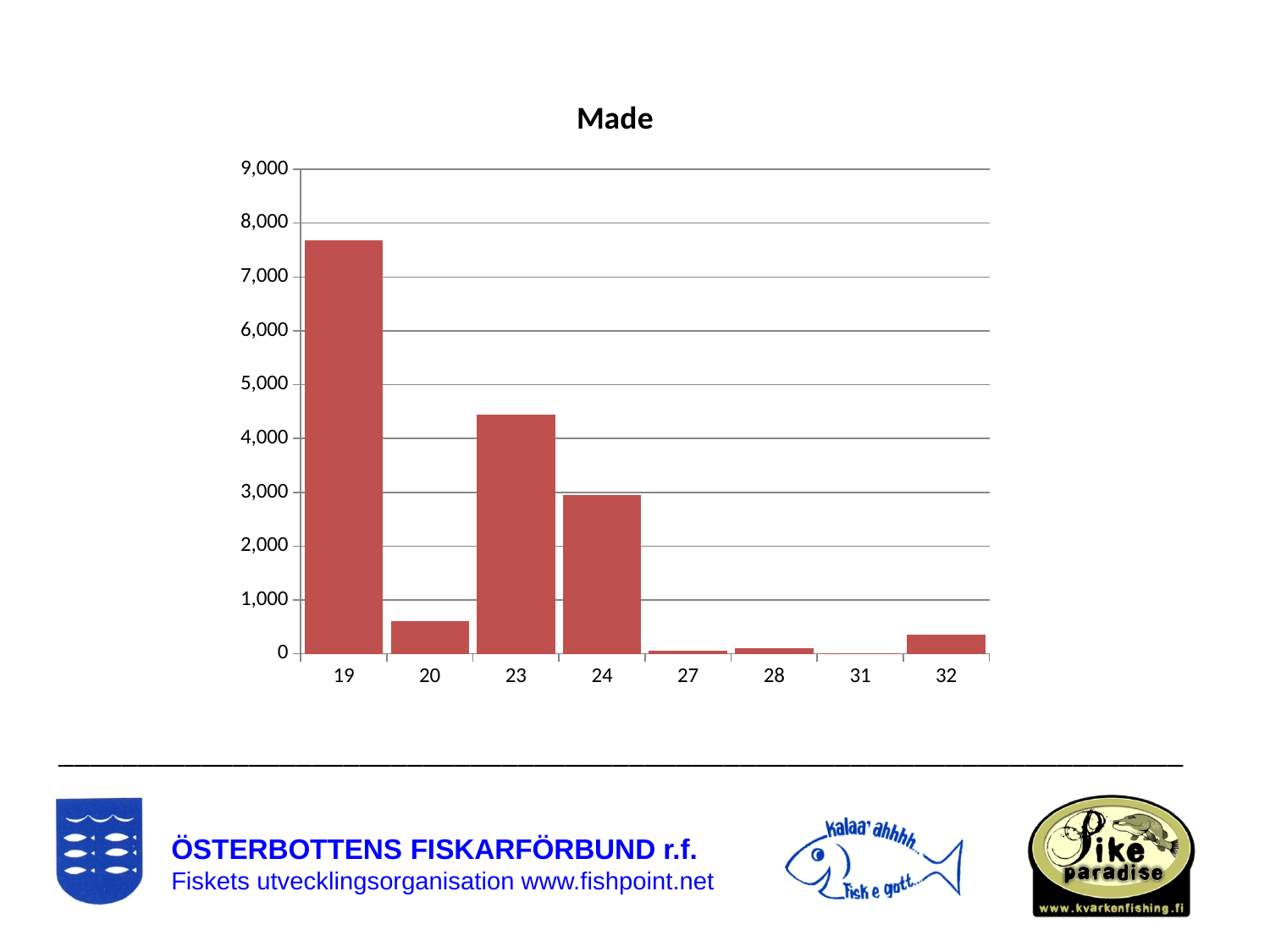
Which has the larger value, category 23 or category 24? 23 How many categories are shown on the x axis of the chart? 8 What kind of chart is shown on the slide? bar chart Is the value for category 20 greater or less than 1,000? less Which category has the highest value in the chart? 19 Is the value for category 32 greater or less than 1,000? less Which has the larger value, category 20 or category 32? 20 Is the value for category 24 greater or less than 2,000? greater What is the highest value shown on the y axis of the chart? 9,000 What is the title of the chart? Made